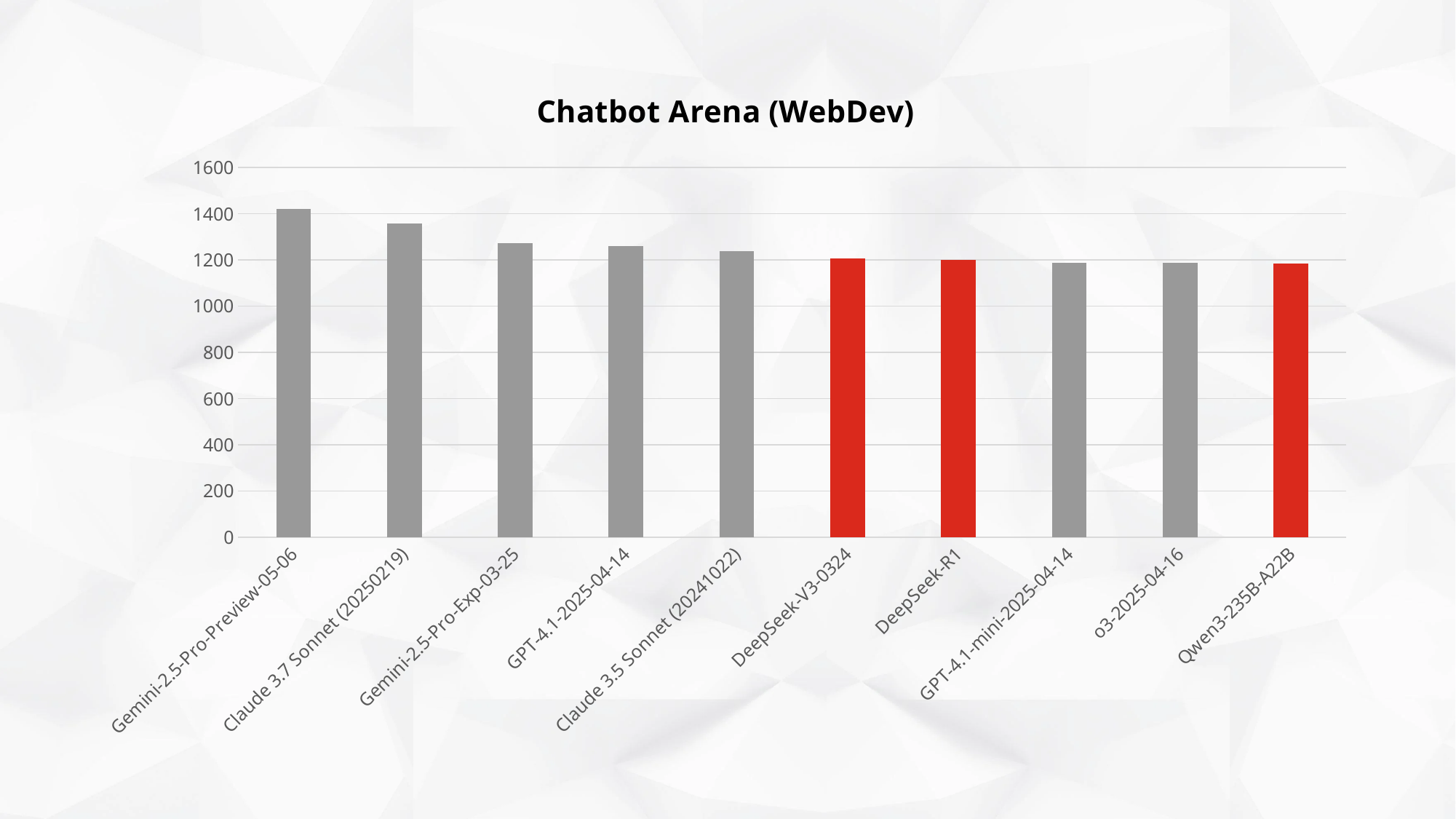
Which is larger, the value for Gemini-2.5-Pro-Preview-05-06 or the value for Claude 3.7 Sonnet (20250219)? Gemini-2.5-Pro-Preview-05-06 How many models (bars) are shown in the chart? 10 Is the value for Claude 3.7 Sonnet (20250219) greater or less than 1200? greater Which model has the highest score in the chart? Gemini-2.5-Pro-Preview-05-06 Is the value for Gemini-2.5-Pro-Preview-05-06 greater or less than 1400? greater Is the value for Gemini-2.5-Pro-Exp-03-25 greater or less than 1400? less Do the values generally rise or fall from left to right along the x axis? fall Which is larger, the value for Claude 3.7 Sonnet (20250219) or the value for Gemini-2.5-Pro-Exp-03-25? Claude 3.7 Sonnet (20250219) What is the title of the chart? Chatbot Arena (WebDev) What kind of chart is shown on the slide? bar chart Which models are shown with red bars? DeepSeek-V3-0324, DeepSeek-R1, Qwen3-235B-A22B